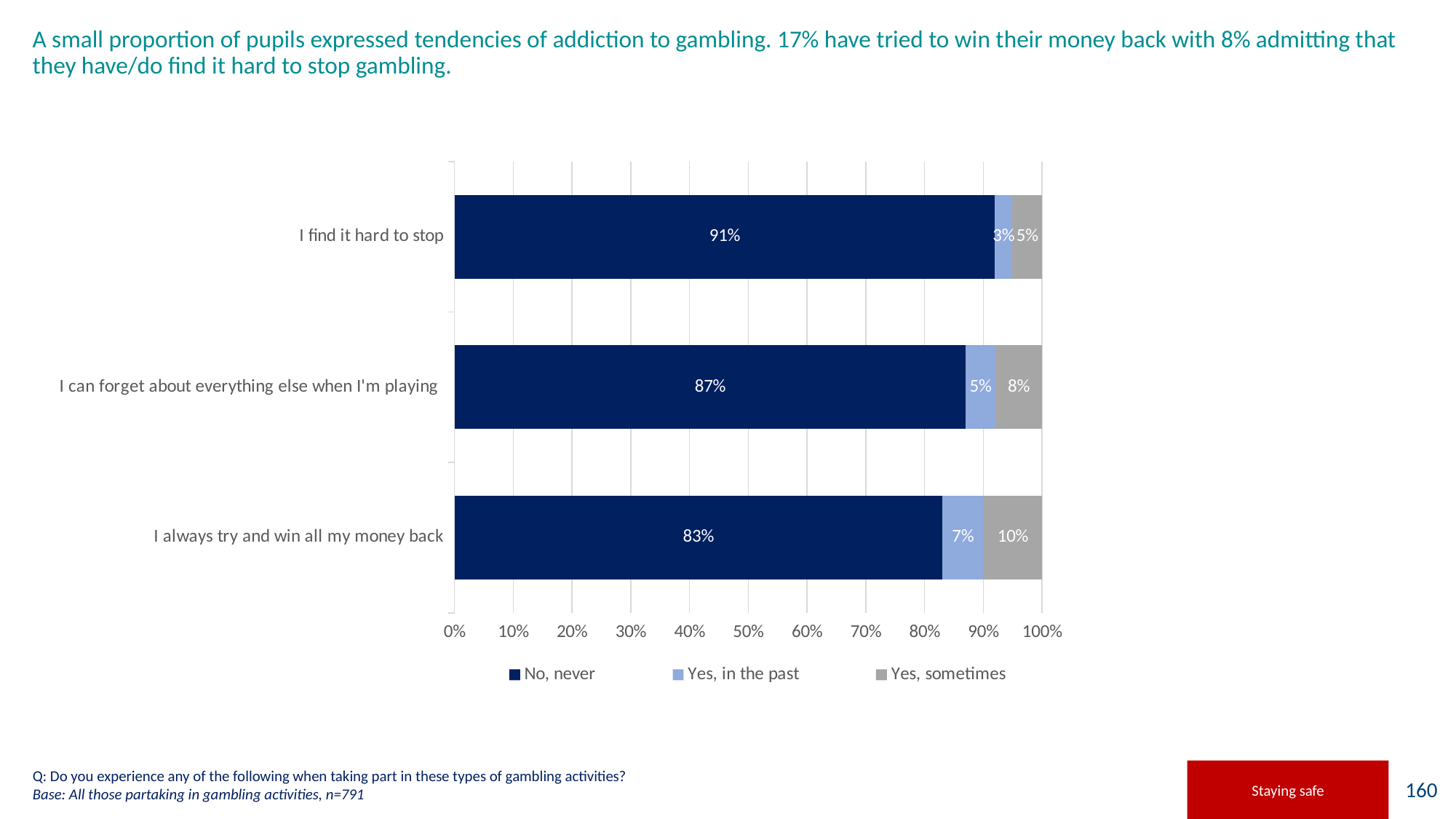
What percentage of pupils answered "Yes, sometimes" for "I always try and win all my money back"? 10% Which statement has the lowest "Yes, sometimes" percentage? I find it hard to stop Is the "No, never" value for "I can forget about everything else when I'm playing" greater or less than 80%? greater What kind of chart is shown on the slide? Stacked bar chart What percentage of pupils answered "Yes, in the past" for "I can forget about everything else when I'm playing"? 5% How many series does the legend list? 3 How many statements are shown on the chart? 3 What percentage of pupils answered "No, never" for "I find it hard to stop"? 91% Which statement has the highest "No, never" percentage? I find it hard to stop What is the combined percentage of "Yes, in the past" and "Yes, sometimes" for "I always try and win all my money back"? 17% Which is larger: the "Yes, in the past" value for "I always try and win all my money back" or for "I find it hard to stop"? I always try and win all my money back What is the difference between the "No, never" percentages for "I find it hard to stop" and "I always try and win all my money back"? 8%